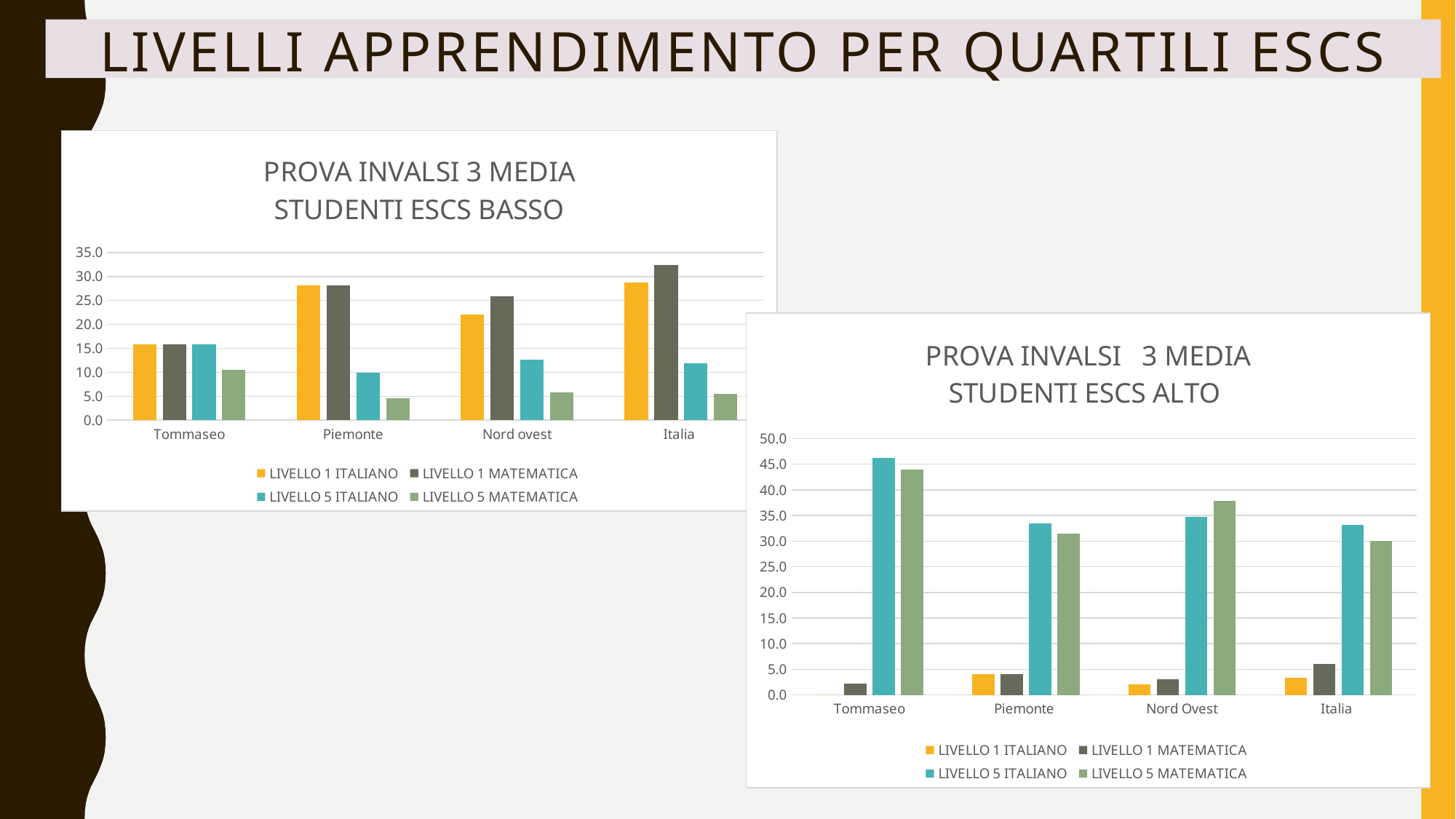
How many series does the legend of the 'PROVA INVALSI 3 MEDIA STUDENTI ESCS BASSO' chart list? 4 In the 'PROVA INVALSI 3 MEDIA STUDENTI ESCS ALTO' chart, for Nord Ovest, which is larger: LIVELLO 5 ITALIANO or LIVELLO 5 MATEMATICA? LIVELLO 5 MATEMATICA In the 'PROVA INVALSI 3 MEDIA STUDENTI ESCS BASSO' chart, what colour represents the LIVELLO 1 ITALIANO series? Orange In the 'PROVA INVALSI 3 MEDIA STUDENTI ESCS ALTO' chart, is the LIVELLO 5 MATEMATICA value for Piemonte greater or less than 35.0? less In the 'PROVA INVALSI 3 MEDIA STUDENTI ESCS ALTO' chart, which category has the highest value for LIVELLO 5 ITALIANO? Tommaseo In the 'PROVA INVALSI 3 MEDIA STUDENTI ESCS BASSO' chart, is the LIVELLO 1 ITALIANO value for Piemonte greater or less than 25.0? greater In the 'PROVA INVALSI 3 MEDIA STUDENTI ESCS BASSO' chart, for Italia, which is larger: LIVELLO 1 ITALIANO or LIVELLO 1 MATEMATICA? LIVELLO 1 MATEMATICA In the 'PROVA INVALSI 3 MEDIA STUDENTI ESCS ALTO' chart, is the LIVELLO 5 ITALIANO value for Tommaseo greater or less than 40.0? greater What kind of chart is the 'PROVA INVALSI 3 MEDIA STUDENTI ESCS BASSO' chart? Bar chart How many categories are shown on the x axis of the 'PROVA INVALSI 3 MEDIA STUDENTI ESCS ALTO' chart? 4 In the 'PROVA INVALSI 3 MEDIA STUDENTI ESCS BASSO' chart, which category has the highest value for LIVELLO 1 MATEMATICA? Italia